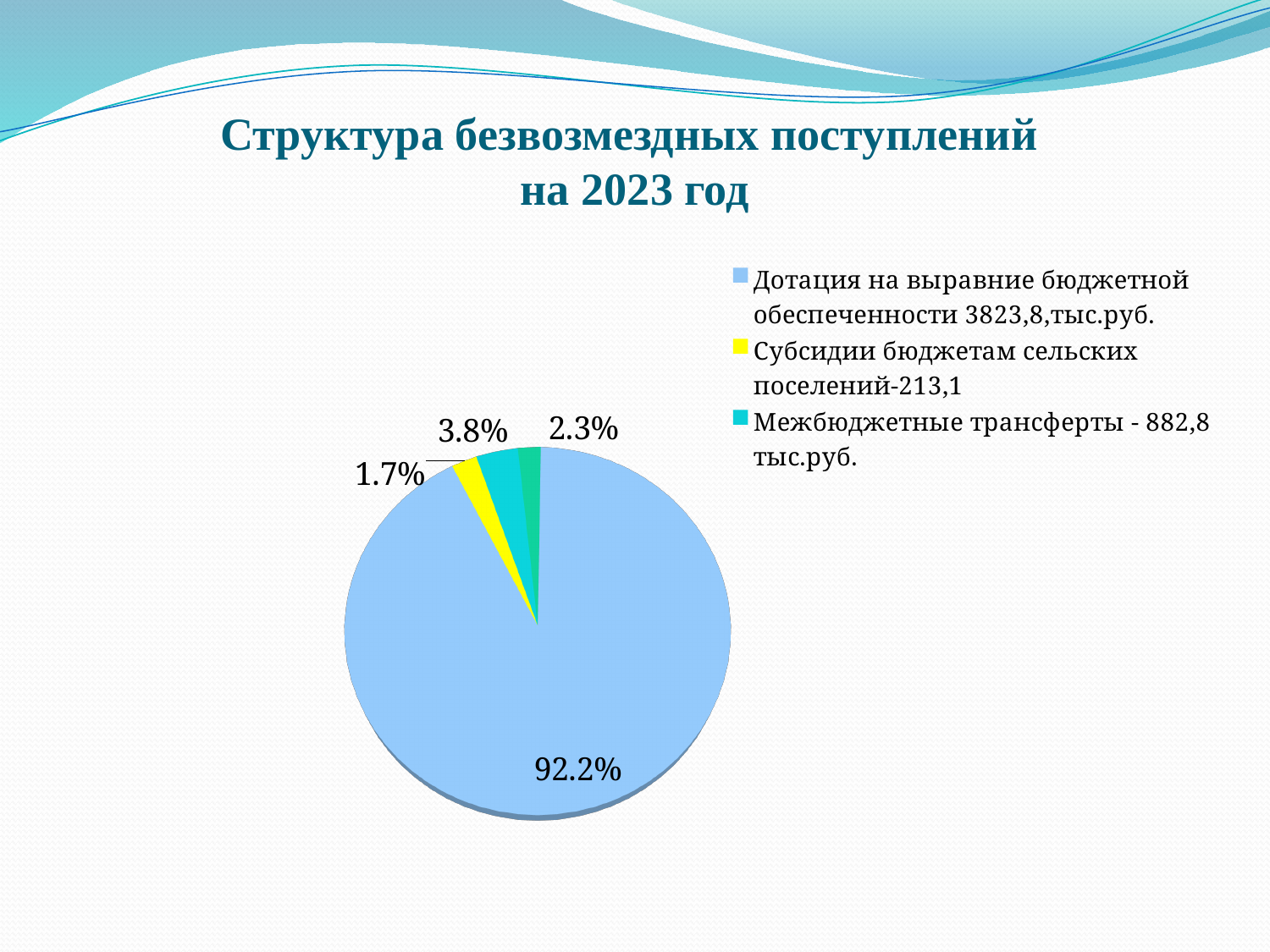
What share of the pie does "Межбюджетные трансферты" take? 3.8% Which legend category has the largest slice of the pie? Дотация на выравние бюджетной обеспеченности What is the difference in percentage points between the "Межбюджетные трансферты" slice and the "Субсидии бюджетам сельских поселений" slice? 2.1 What is the title of the chart on the slide? Структура безвозмездных поступлений на 2023 год How many entries does the legend list? 3 What kind of chart is shown on the slide? pie chart Which slice is larger: "Межбюджетные трансферты" or "Субсидии бюджетам сельских поселений"? Межбюджетные трансферты What share of the pie does "Дотация на выравние бюджетной обеспеченности" take? 92.2% Which legend category has the smallest slice of the pie? Субсидии бюджетам сельских поселений How many slices does the pie chart have? 4 What amount in тыс.руб. does the legend give for "Межбюджетные трансферты"? 882,8 What share of the pie does "Субсидии бюджетам сельских поселений" take? 1.7%